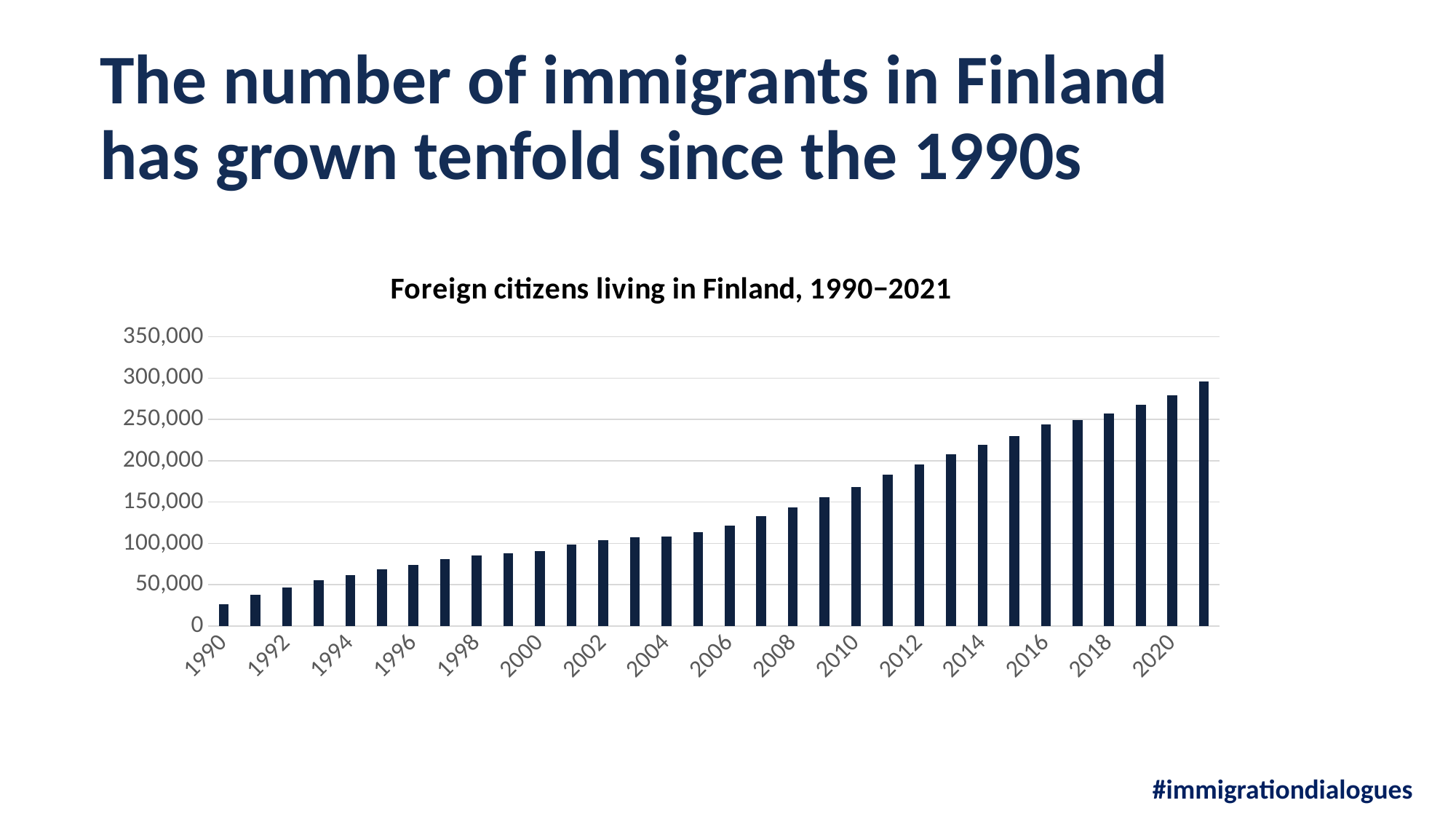
Which year has the lowest value? 1990 How many bars (years) are plotted in the chart? 32 Is the value for 2020 greater or less than 250,000? greater What is the title of the chart? Foreign citizens living in Finland, 1990–2021 Do the values rise or fall from 1990 to 2021? Rise What kind of chart is shown on the slide? Bar chart What is the highest value shown on the vertical axis? 350,000 Which year has the highest value? 2021 Is the value for 1990 greater or less than 50,000? less Which year has the larger value, 2000 or 2010? 2010 Is the value for 2016 greater or less than 200,000? greater